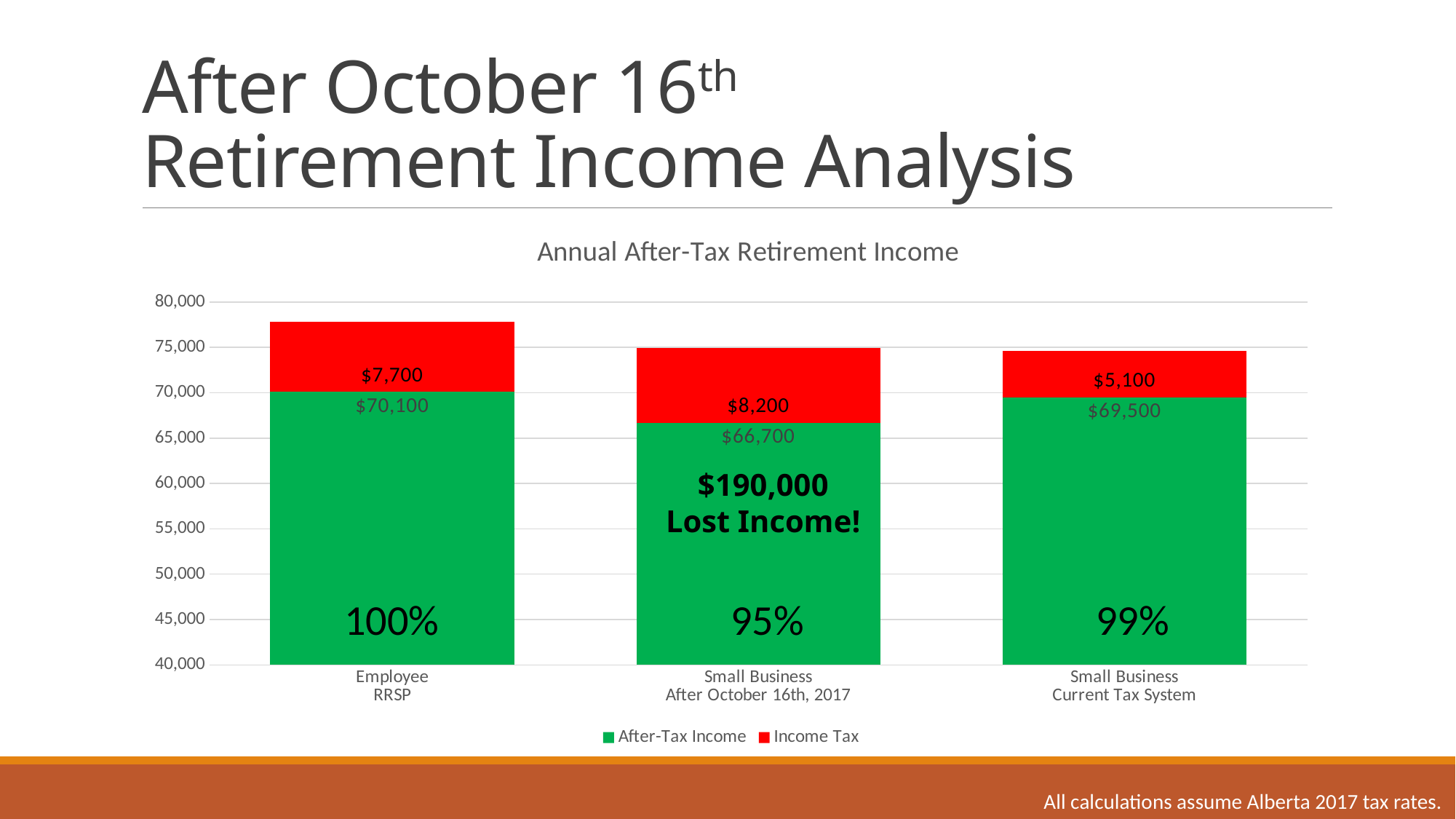
What is the Income Tax value for Small Business After October 16th, 2017? $8,200 How many categories are shown on the x axis? 3 What is the After-Tax Income value for Small Business Current Tax System? $69,500 How many series does the legend list? 2 What is the title of the chart? Annual After-Tax Retirement Income What kind of chart is shown on the slide? Stacked bar chart What is the After-Tax Income value for Employee RRSP? $70,100 What is the difference in After-Tax Income between Employee RRSP and Small Business After October 16th, 2017? $3,400 Which category has the highest After-Tax Income? Employee RRSP Which is larger, the Income Tax for Employee RRSP or for Small Business After October 16th, 2017? Small Business After October 16th, 2017 Which category has the lowest Income Tax? Small Business Current Tax System What is the total of the stacked bar for Small Business Current Tax System? $74,600